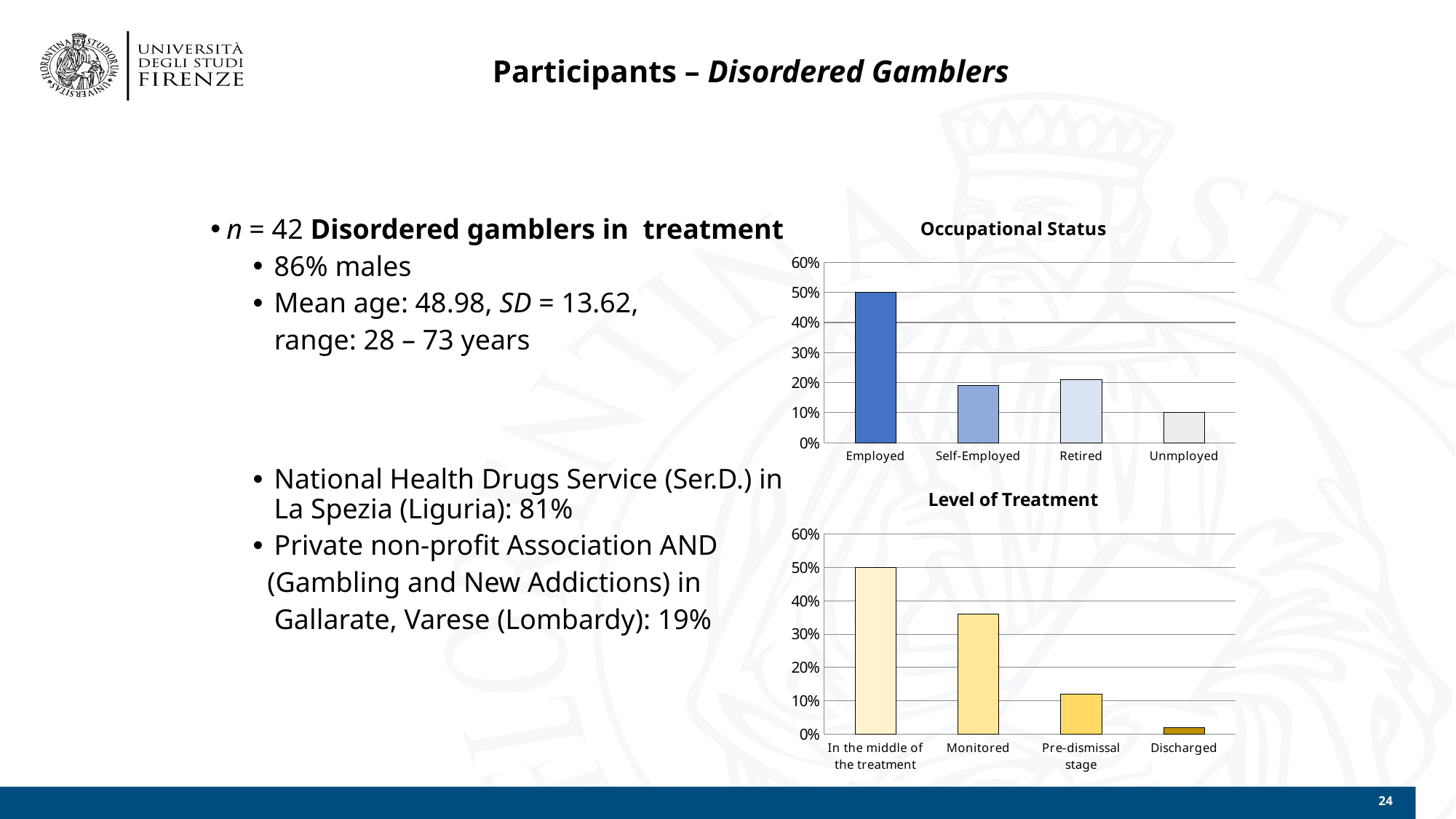
In the Occupational Status chart, which category has the lowest value? Unmployed In the Level of Treatment chart, which category has the highest value? In the middle of the treatment In the Occupational Status chart, is the value for Self-Employed greater or less than 30%? less In the Level of Treatment chart, is the value for Monitored greater or less than 30%? greater In the Occupational Status chart, is the value for Employed greater or less than 40%? greater In the Level of Treatment chart, which category has the lowest value? Discharged In the Level of Treatment chart, do the values rise or fall from left to right along the x axis? Fall In the Level of Treatment chart, which is larger, the value for Monitored or the value for Pre-dismissal stage? Monitored In the Occupational Status chart, how many categories are shown? 4 In the Occupational Status chart, which category has the highest value? Employed What type of chart is the Occupational Status chart? Bar chart